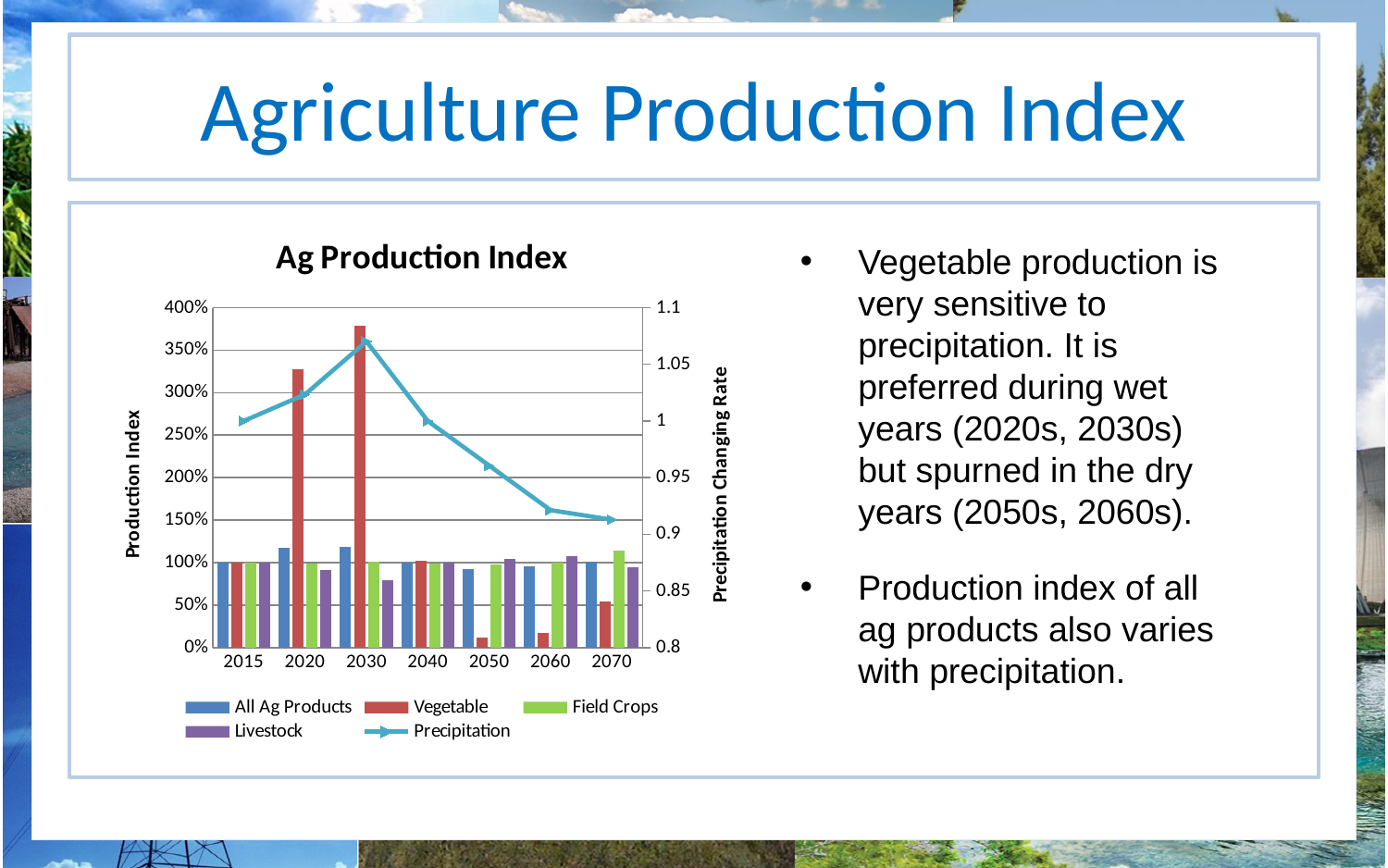
Does the Precipitation line rise or fall from 2030 to 2070? It falls In which year does the Precipitation line reach its lowest point? 2070 What kind of chart is the Ag Production Index chart? A bar chart combined with a line chart What is the title of the right-hand vertical axis of the chart? Precipitation Changing Rate How many years are shown on the x axis of the Ag Production Index chart? 7 Is the Vegetable value for 2030 greater or less than 350%? greater Which year has the larger Vegetable value, 2020 or 2030? 2030 In which year is the Vegetable production index highest? 2030 Is the Vegetable value for 2050 greater or less than 50%? less In which year does the Precipitation line reach its highest point? 2030 Is the Vegetable value for 2020 greater or less than 300%? greater How many series does the legend of the Ag Production Index chart list? 5